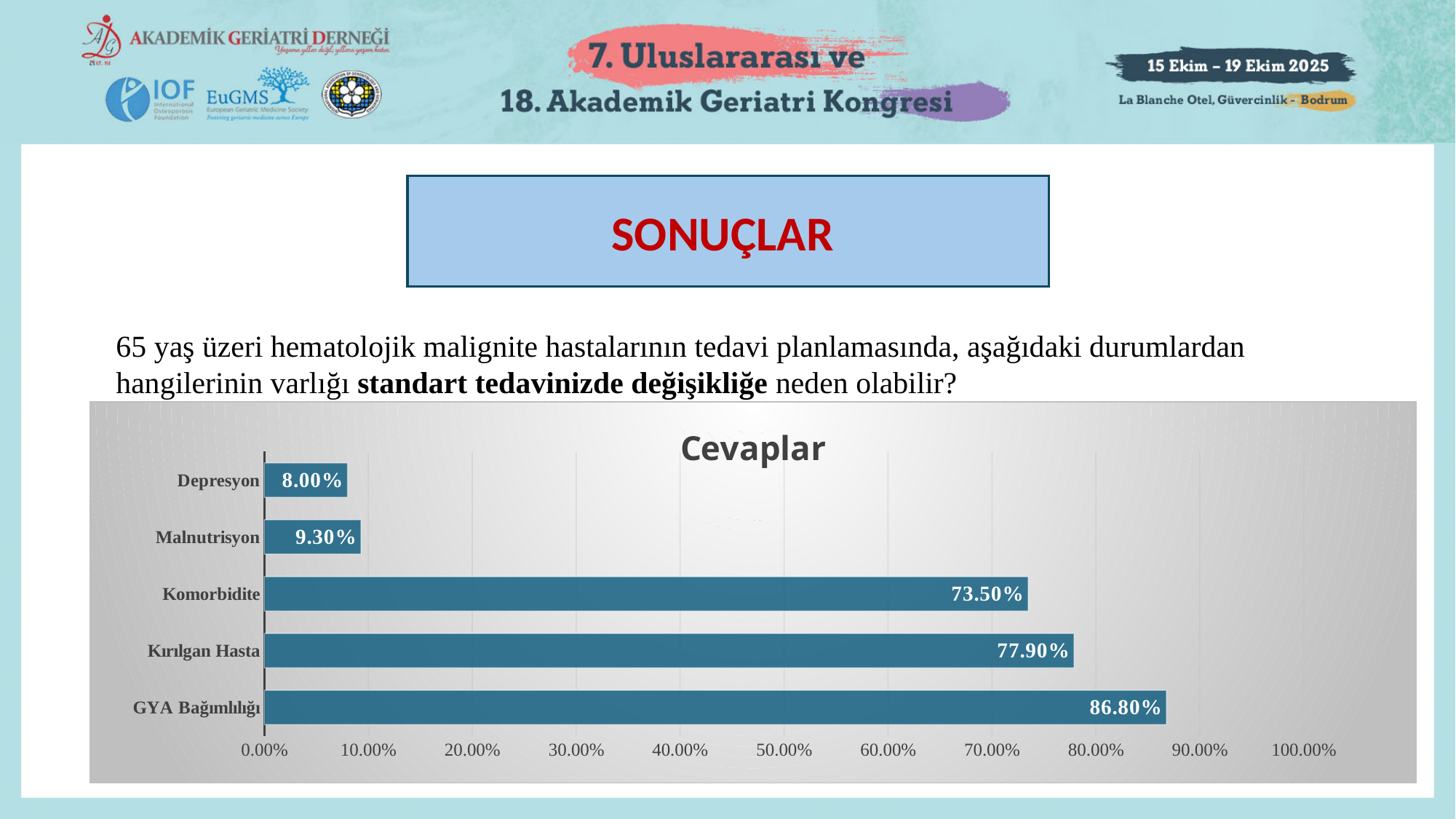
What is the value for GYA Bağımlılığı? 86.80% How many categories are shown in the chart? 5 What is the difference between the values for Kırılgan Hasta and Komorbidite? 4.40% What kind of chart is shown on the slide? bar chart What is the value for Depresyon? 8.00% Which category has the highest value? GYA Bağımlılığı Which is larger, the value for Malnutrisyon or the value for Depresyon? Malnutrisyon What is the title of the chart? Cevaplar What is the value for Malnutrisyon? 9.30% Is the value for Kırılgan Hasta greater or less than 70.00%? greater What is the value for Komorbidite? 73.50% Which category has the lowest value? Depresyon